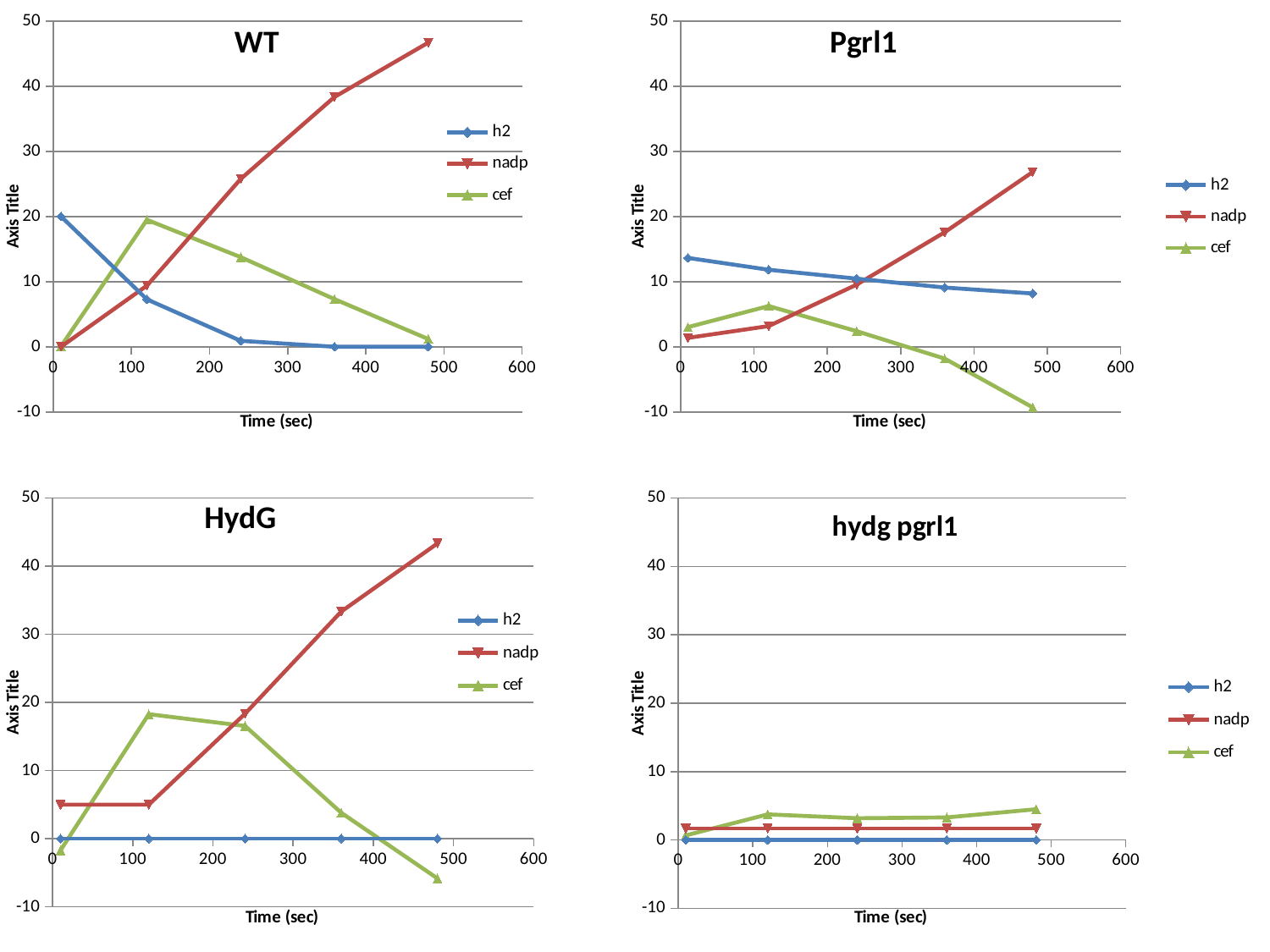
In the HydG chart, at 480 sec, which is larger: nadp or cef? nadp In the hydg pgrl1 chart, which series has the highest value at 480 sec? cef In the WT chart, is the nadp value at 480 sec greater or less than 40? greater What is the x-axis title of the HydG chart? Time (sec) What kind of chart is the WT chart? line chart In the HydG chart, is the cef value at 120 sec greater or less than 10? greater In the Pgrl1 chart, is the nadp value at 480 sec greater or less than 20? greater In the WT chart, does the nadp series rise or fall as time increases? rise In the Pgrl1 chart, does the cef series rise or fall after 120 sec? fall How many data points does the nadp series have in the HydG chart? 5 How many series does the legend of the WT chart list? 3 In the WT chart, does the h2 series rise or fall as time increases? fall